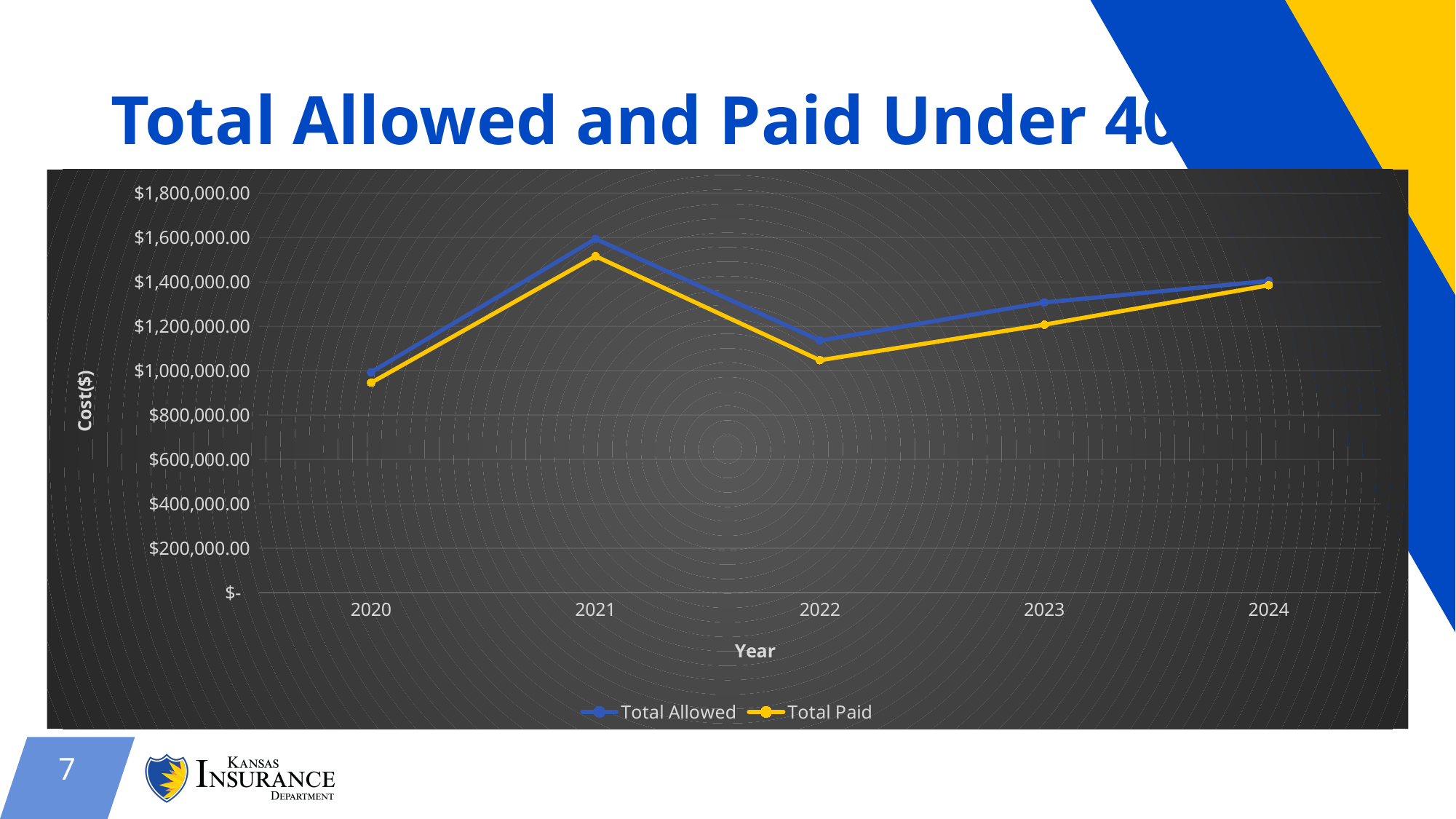
Does Total Allowed rise or fall from 2022 to 2024? Rise In which year is Total Paid lowest? 2020 Is the Total Allowed value for 2021 greater or less than $1,400,000.00? greater What is the label on the vertical axis? Cost($) Is the Total Paid value for 2022 greater or less than $1,200,000.00? less Which is larger in 2023, Total Allowed or Total Paid? Total Allowed In which year is Total Allowed highest? 2021 What kind of chart is shown on the slide? Line chart Which series is drawn in yellow? Total Paid How many series does the legend list? 2 Is the Total Paid value for 2020 greater or less than $1,000,000.00? less How many years are plotted along the x axis? 5